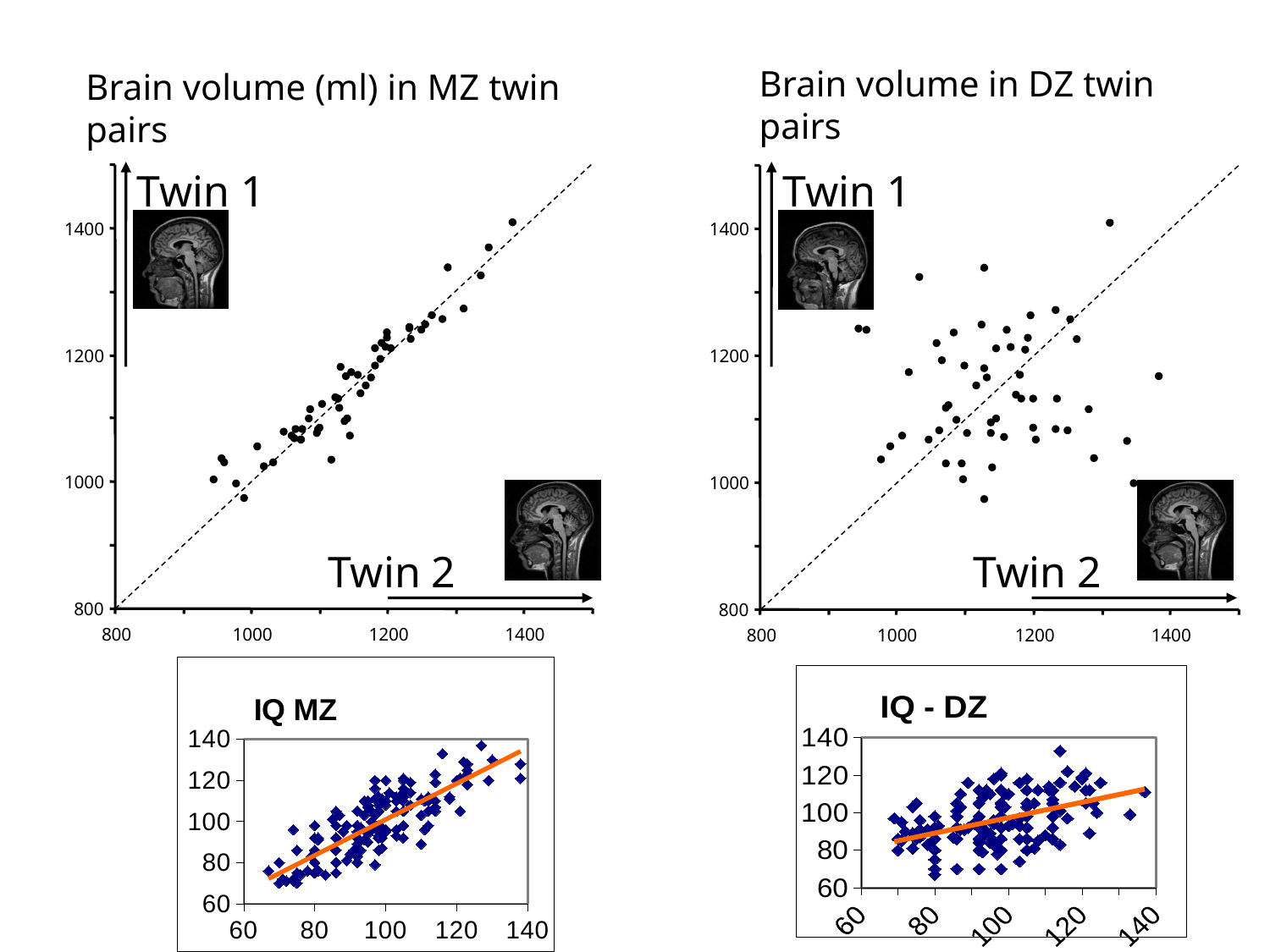
Which chart has points lying closer to the dashed diagonal line, "Brain volume (ml) in MZ twin pairs" or "Brain volume in DZ twin pairs"? Brain volume (ml) in MZ twin pairs In the "Brain volume (ml) in MZ twin pairs" chart, do the Twin 1 values rise or fall as the Twin 2 values increase? rise In the "IQ - DZ" chart, does the fitted line rise or fall from left to right? rise In the "IQ - DZ" chart, is the lowest plotted IQ value greater or less than 80? less In the "IQ MZ" chart, do the values rise or fall as the x-axis value increases? rise What is the lowest tick value shown on the x-axis of the "Brain volume in DZ twin pairs" chart? 800 What kind of chart is the "IQ MZ" chart? scatter plot What is the highest tick value shown on the y-axis of the "IQ MZ" chart? 140 What kind of chart is the "Brain volume (ml) in MZ twin pairs" chart? scatter plot How many charts are shown on the slide? 4 Which chart shows a tighter clustering of points around the fitted line, "IQ MZ" or "IQ - DZ"? IQ MZ